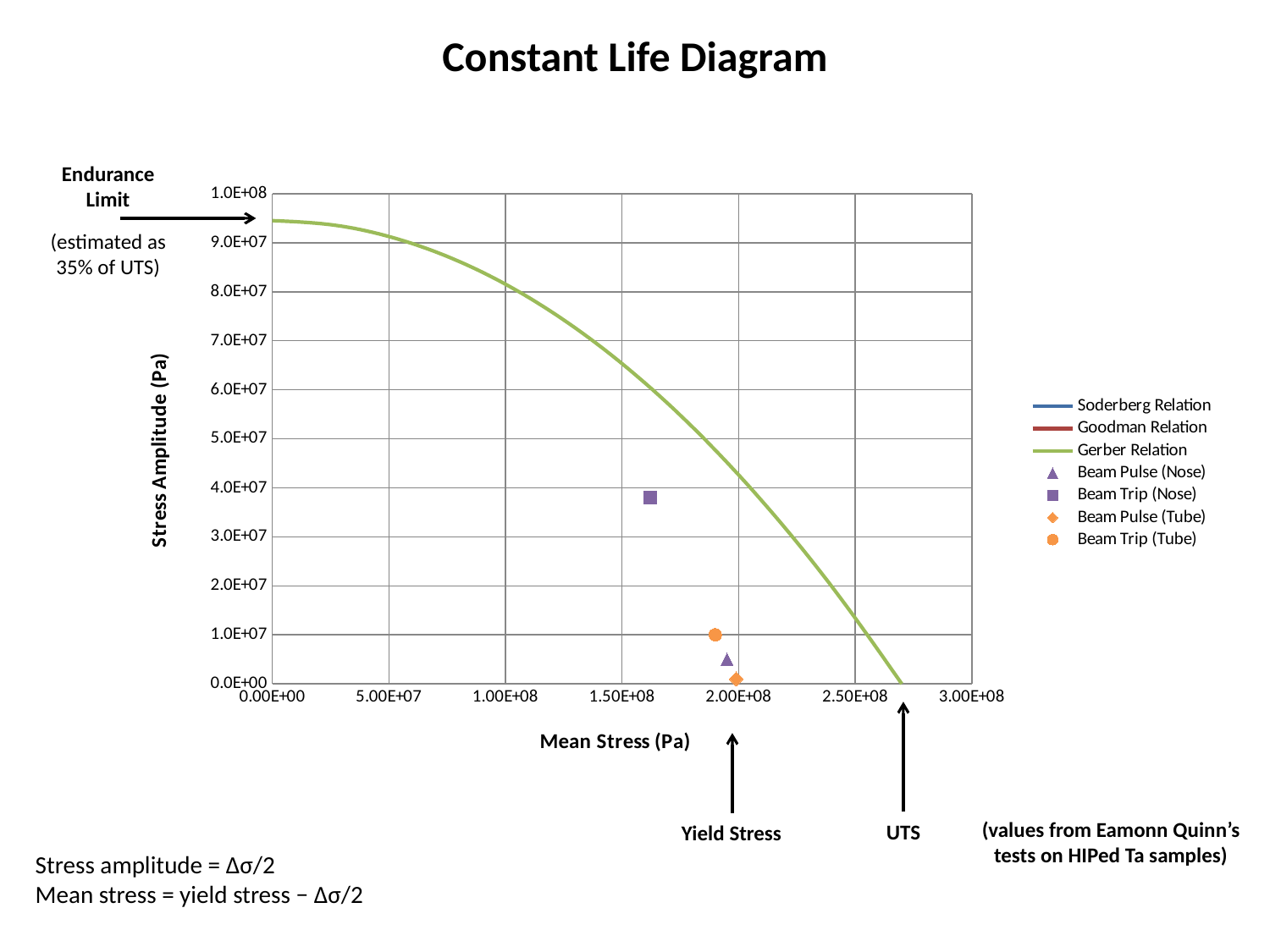
Does the Gerber Relation curve rise or fall as mean stress increases along the x axis? fall Is the stress amplitude of the Beam Trip (Nose) point greater or less than 4.0E+07? less What is the title of the chart? Constant Life Diagram Which plotted data point has the highest stress amplitude? Beam Trip (Nose) Is the stress amplitude of the Beam Pulse (Tube) point greater or less than 1.0E+07? less What is the label of the vertical axis? Stress Amplitude (Pa) Is the stress amplitude where the Gerber Relation curve meets the vertical axis greater or less than 9.0E+07? greater Which has the higher stress amplitude, Beam Trip (Tube) or Beam Pulse (Nose)? Beam Trip (Tube) How many series does the chart legend list? 7